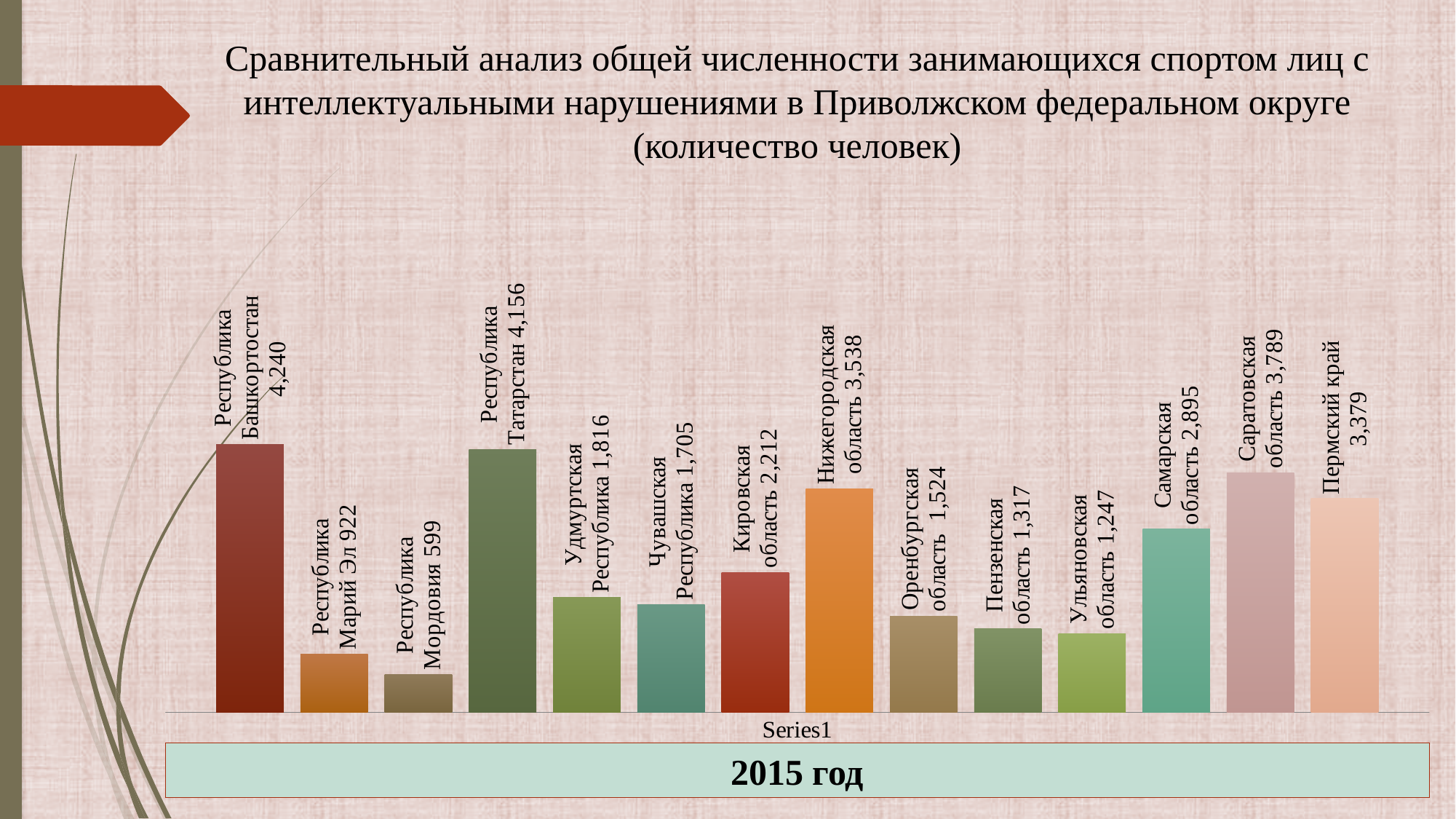
What is the value for Пермский край? 3,379 Which region has the lowest value? Республика Мордовия How many regions are shown in the chart? 14 What is the value for Нижегородская область? 3,538 Which region has the highest value? Республика Башкортостан Which year does the chart refer to, according to the label below it? 2015 год What is the difference between the values for Саратовская область and Самарская область? 894 What kind of chart is shown on the slide? bar chart What is the value for Республика Башкортостан? 4,240 What is the value for Ульяновская область? 1,247 Which is larger, the value for Саратовская область or the value for Пермский край? Саратовская область What is the difference between the values for Республика Башкортостан and Республика Татарстан? 84